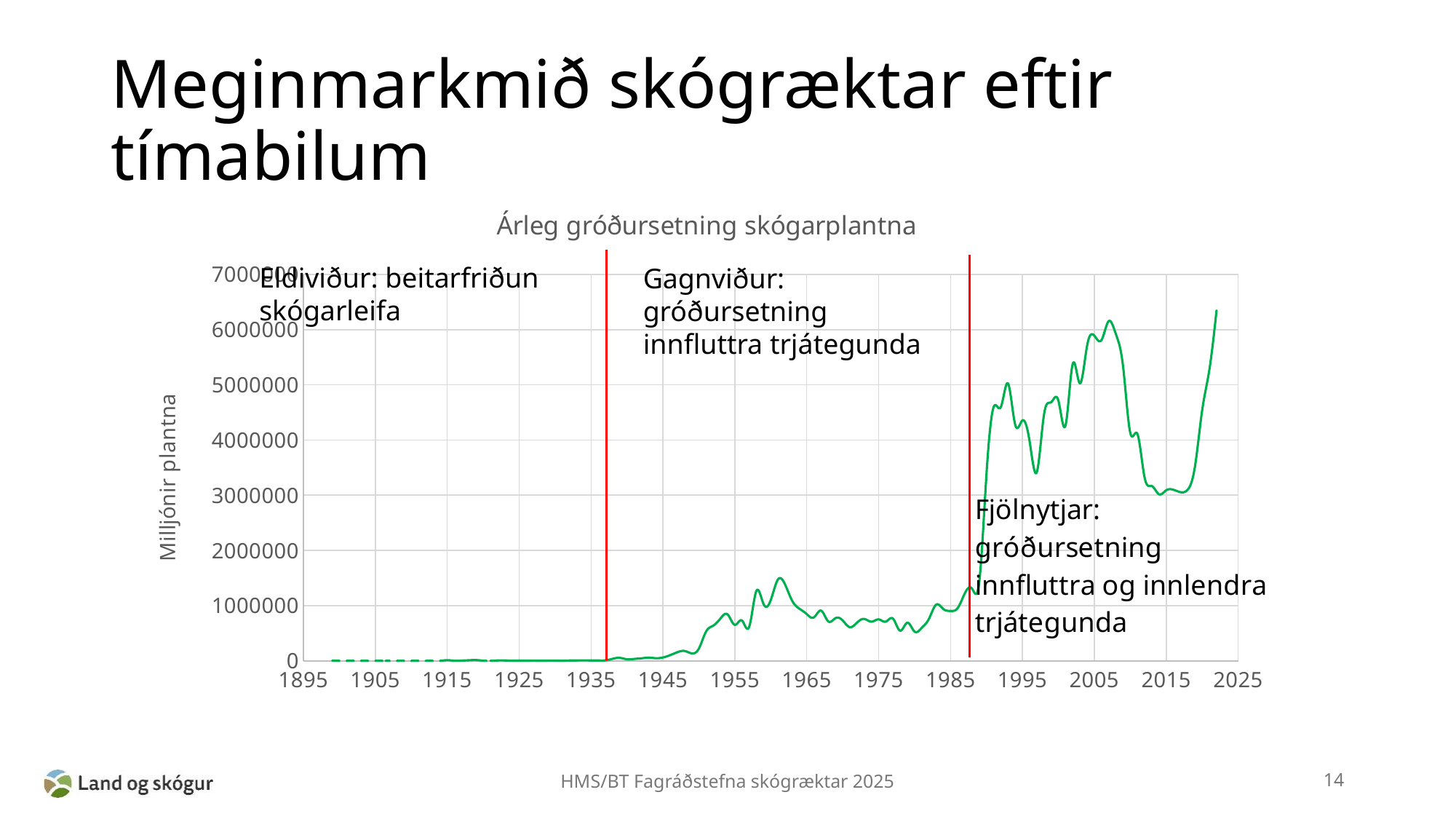
What is the title of the chart? Árleg gróðursetning skógarplantna Do the values rise or fall between 2005 and 2015? fall Is the value for 2005 greater or less than 5000000? greater Is the value for 2015 greater or less than 4000000? less Is the value for 1995 greater or less than 3000000? greater How many red vertical lines divide the chart into periods? 2 What kind of chart is shown on the slide? line chart Which year has the larger value, 1975 or 2005? 2005 Which year has the larger value, 1960 or 2000? 2000